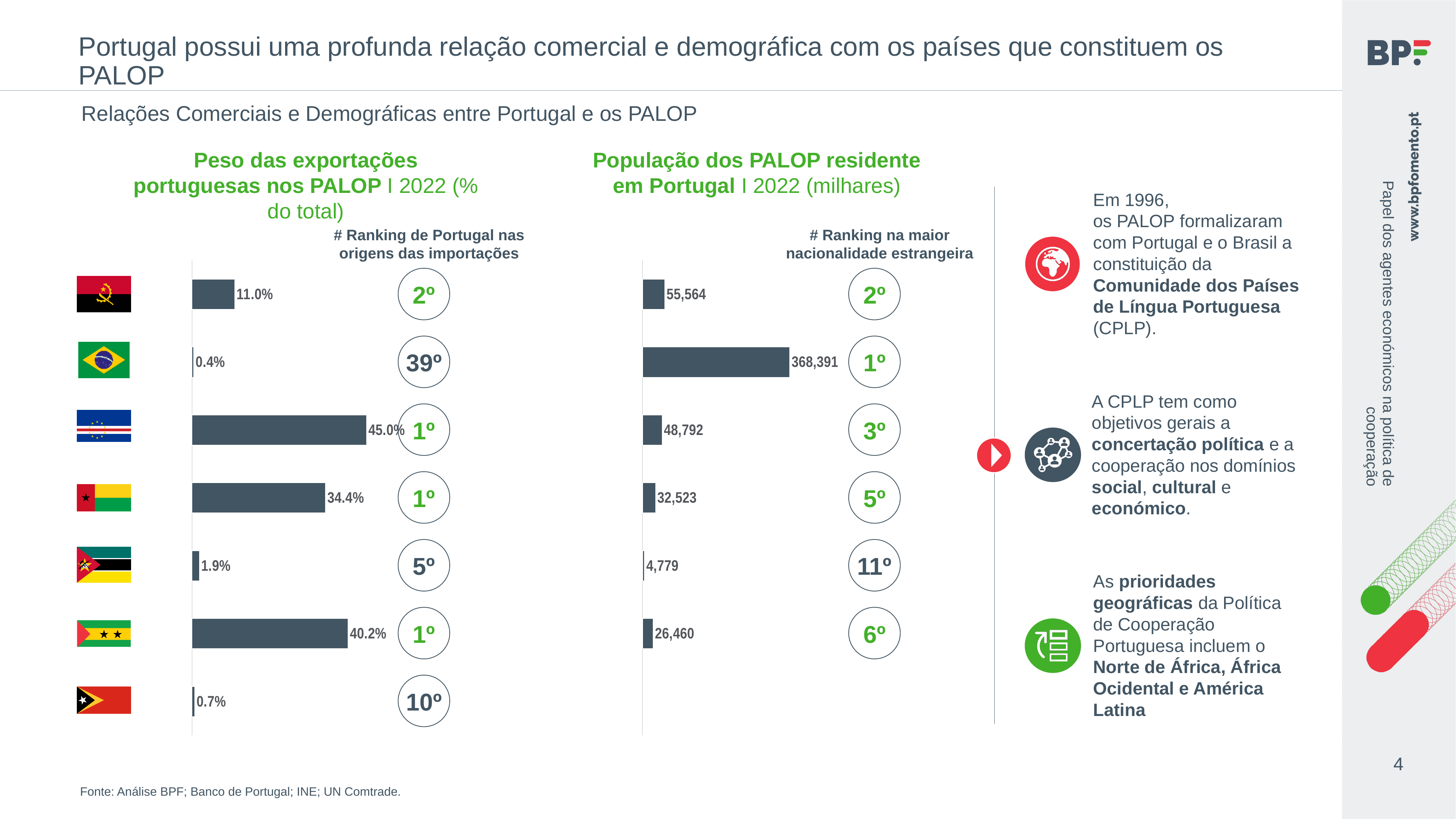
In the chart 'Peso das exportações portuguesas nos PALOP', what is the difference between the third bar (45.0%) and the sixth bar (40.2%)? 4.8% In the chart 'Peso das exportações portuguesas nos PALOP', how many bars (categories) are shown? 7 In the chart 'População dos PALOP residente em Portugal', which is larger: the topmost bar or the third bar from the top? the topmost bar (55,564) In the chart 'População dos PALOP residente em Portugal', what is the value of the second bar from the top? 368,391 In the chart 'Peso das exportações portuguesas nos PALOP', what is the lowest value shown? 0.4% In the chart 'População dos PALOP residente em Portugal', what ranking is shown in the circle next to the second bar from the top? 1º In the chart 'Peso das exportações portuguesas nos PALOP', what is the value of the third bar from the top? 45.0% In the chart 'População dos PALOP residente em Portugal', what is the difference between the topmost bar (55,564) and the third bar (48,792)? 6,772 In the chart 'População dos PALOP residente em Portugal', what is the lowest value shown? 4,779 In the chart 'Peso das exportações portuguesas nos PALOP', what is the value of the topmost bar? 11.0% What type of chart is 'Peso das exportações portuguesas nos PALOP'? bar chart In the chart 'Peso das exportações portuguesas nos PALOP', what is the highest value shown? 45.0%